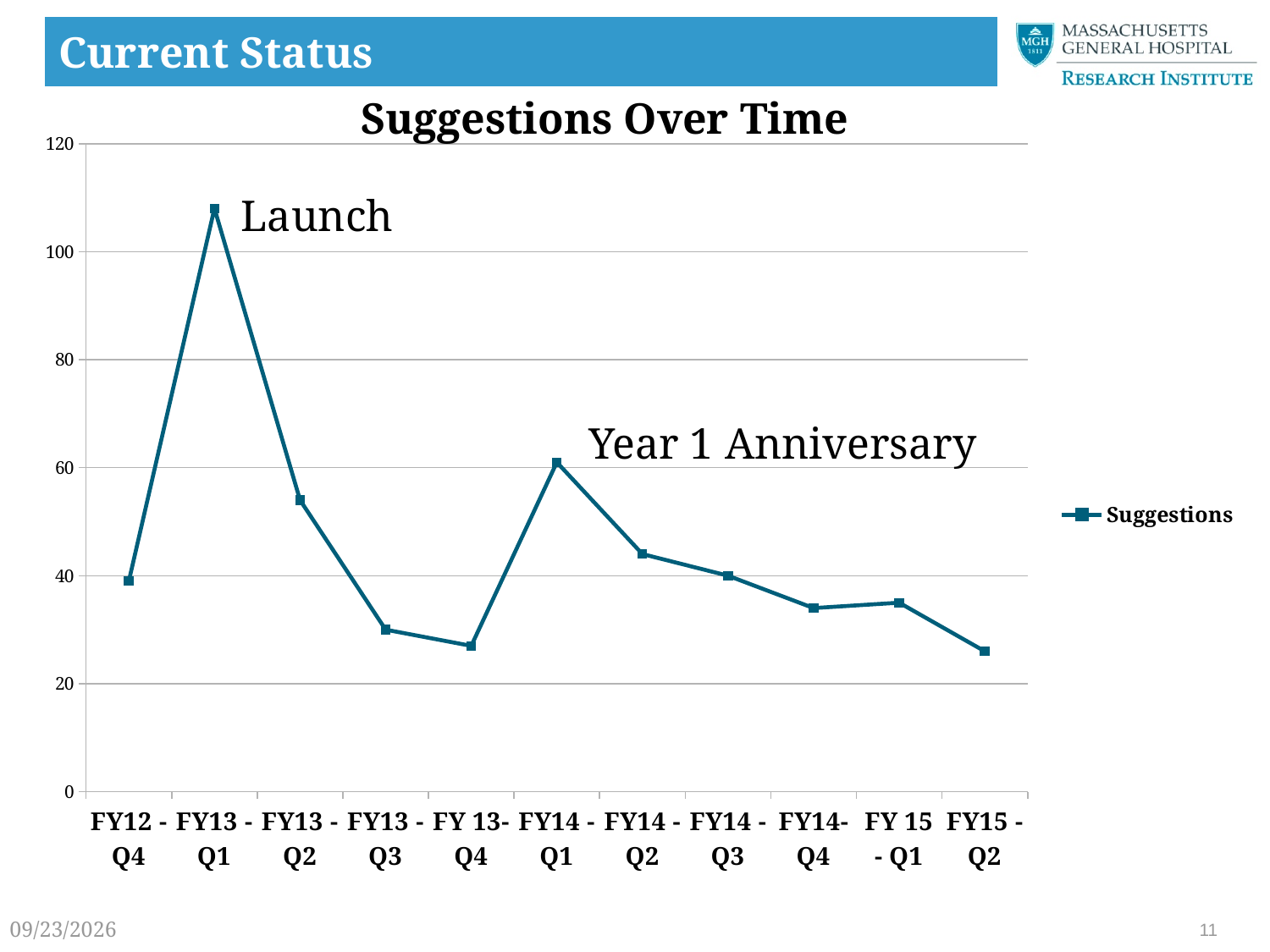
Is the value for FY15 - Q2 greater or less than 40? less How many series does the legend list? 1 Do the values rise or fall from FY14 - Q1 to FY15 - Q2? fall Which is larger, the value for FY13 - Q1 or the value for FY14 - Q1? FY13 - Q1 What is the title of the chart? Suggestions Over Time How many quarters are plotted along the x axis? 11 Which quarter has the highest number of suggestions? FY13 - Q1 What type of chart is shown on the slide? Line chart Is the value for FY13 - Q2 greater or less than 60? less Is the value for FY13 - Q3 greater or less than 40? less Which annotation is placed next to the peak at FY13 - Q1? Launch